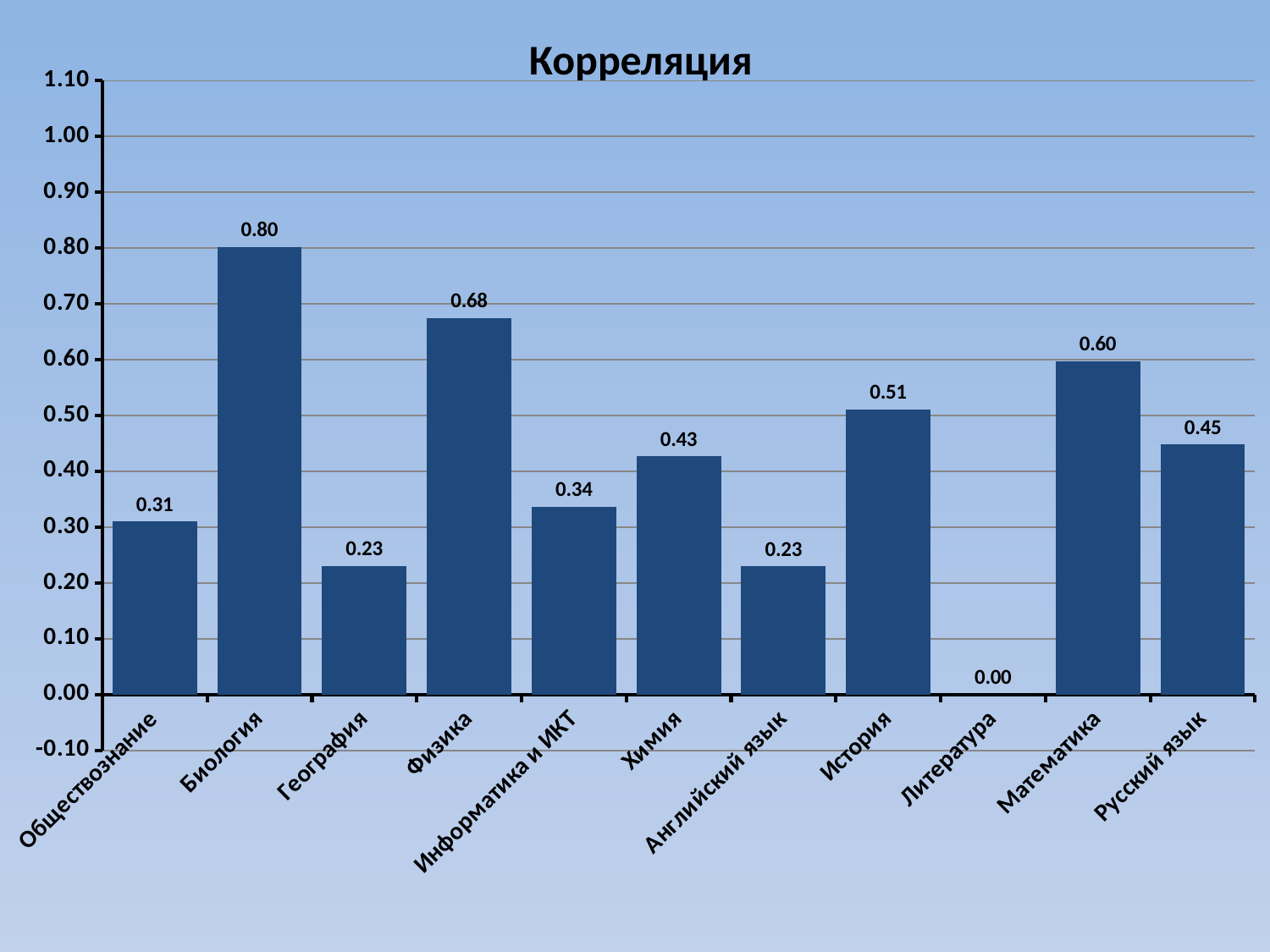
What is the value for Биология? 0.80 What kind of chart is this? bar chart What is the value for Информатика и ИКТ? 0.34 How many categories are shown on the x axis? 11 Which category has the lowest value? Литература Which two categories share the value 0.23? География and Английский язык Is the value for Математика greater or less than 0.50? greater What is the value for Литература? 0.00 What is the difference between the values for Физика and Химия? 0.25 Which category has the highest value? Биология What is the title of the chart? Корреляция Which is larger, the value for История or the value for Русский язык? История